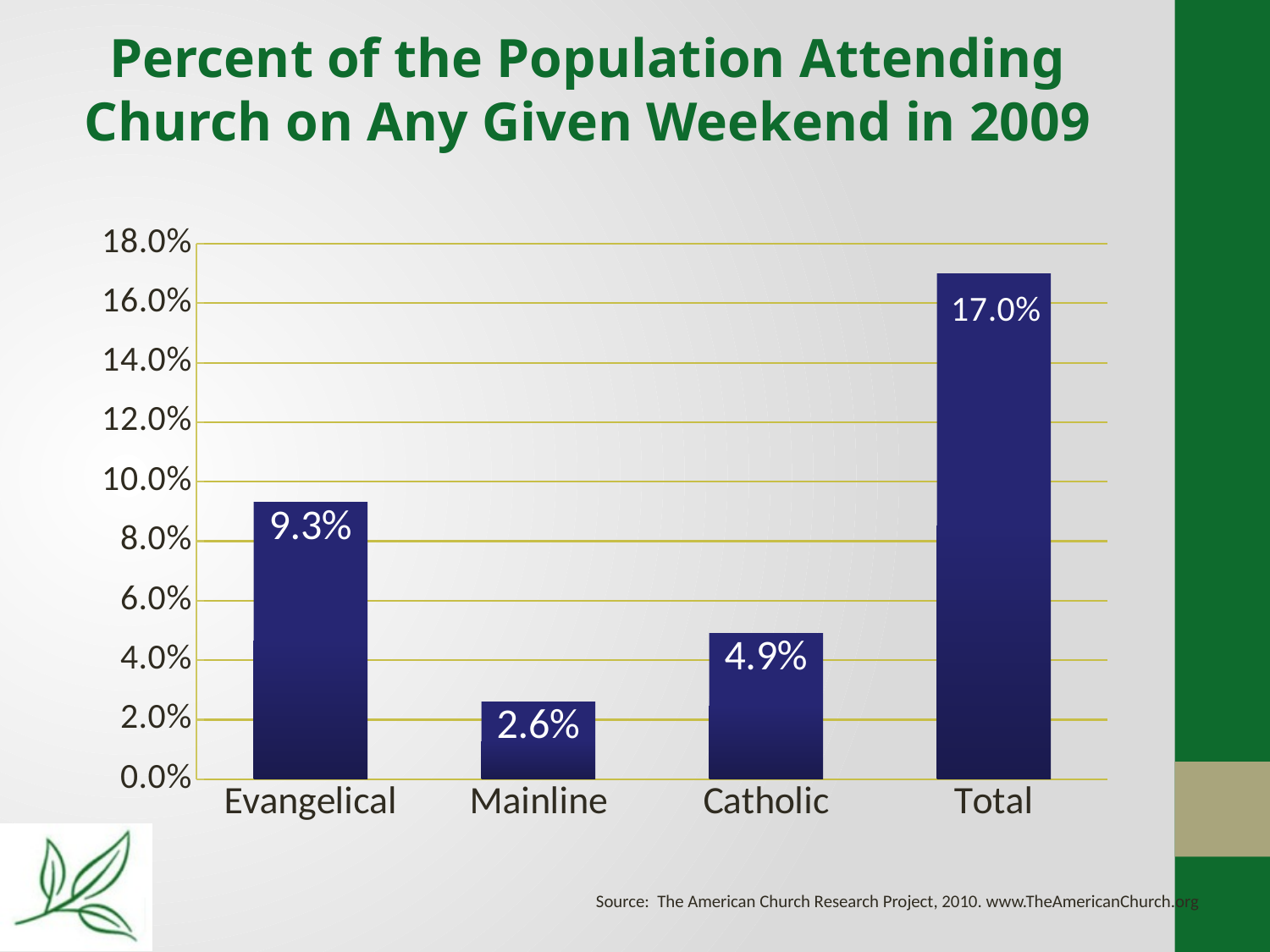
Which category has the lowest value? Mainline What value is shown for Catholic? 4.9% What kind of chart is shown on the slide? Bar chart Which is larger, the value for Catholic or the value for Mainline? Catholic How many categories are shown on the x axis? 4 What value is shown for Mainline? 2.6% Which category has the highest value? Total What is the difference between the Evangelical and Catholic values? 4.4% What is the title of the chart? Percent of the Population Attending Church on Any Given Weekend in 2009 What is the difference between the Total and Evangelical values? 7.7% What percent of the population attending church on any given weekend in 2009 is shown for Evangelical? 9.3% What value is shown for Total? 17.0%